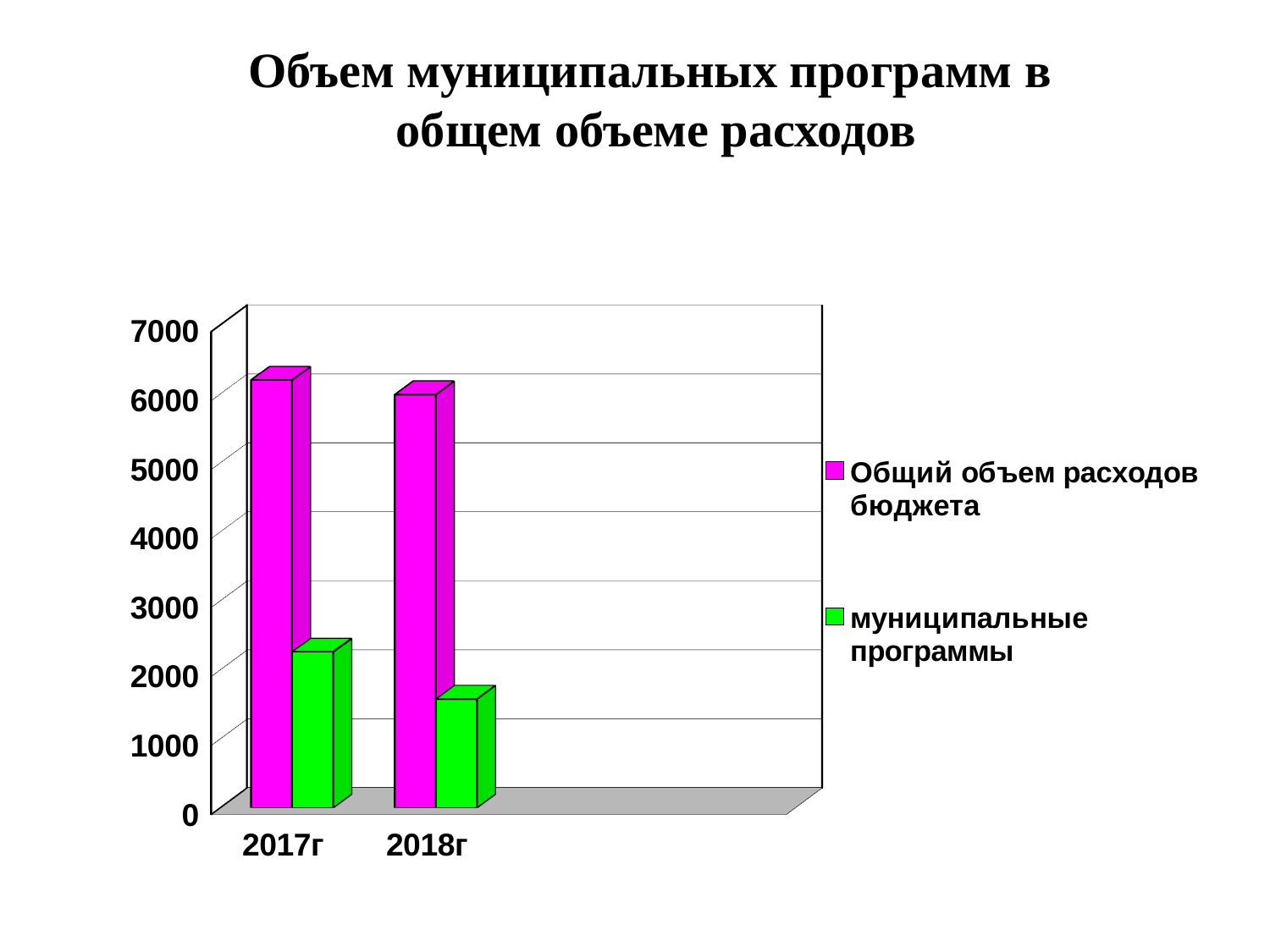
How many series does the legend list? 2 Is the value for Общий объем расходов бюджета in 2017г greater or less than 5000? greater How many categories are shown on the x axis? 2 Is the value for муниципальные программы in 2018г greater or less than 1000? greater What kind of chart is shown on the slide? bar chart Do the values for муниципальные программы rise or fall from 2017г to 2018г? fall Which year has the larger value for муниципальные программы, 2017г or 2018г? 2017г Is the value for Общий объем расходов бюджета in 2018г greater or less than 5000? greater Which two categories are shown on the x axis? 2017г and 2018г What is the title of the chart? Объем муниципальных программ в общем объеме расходов